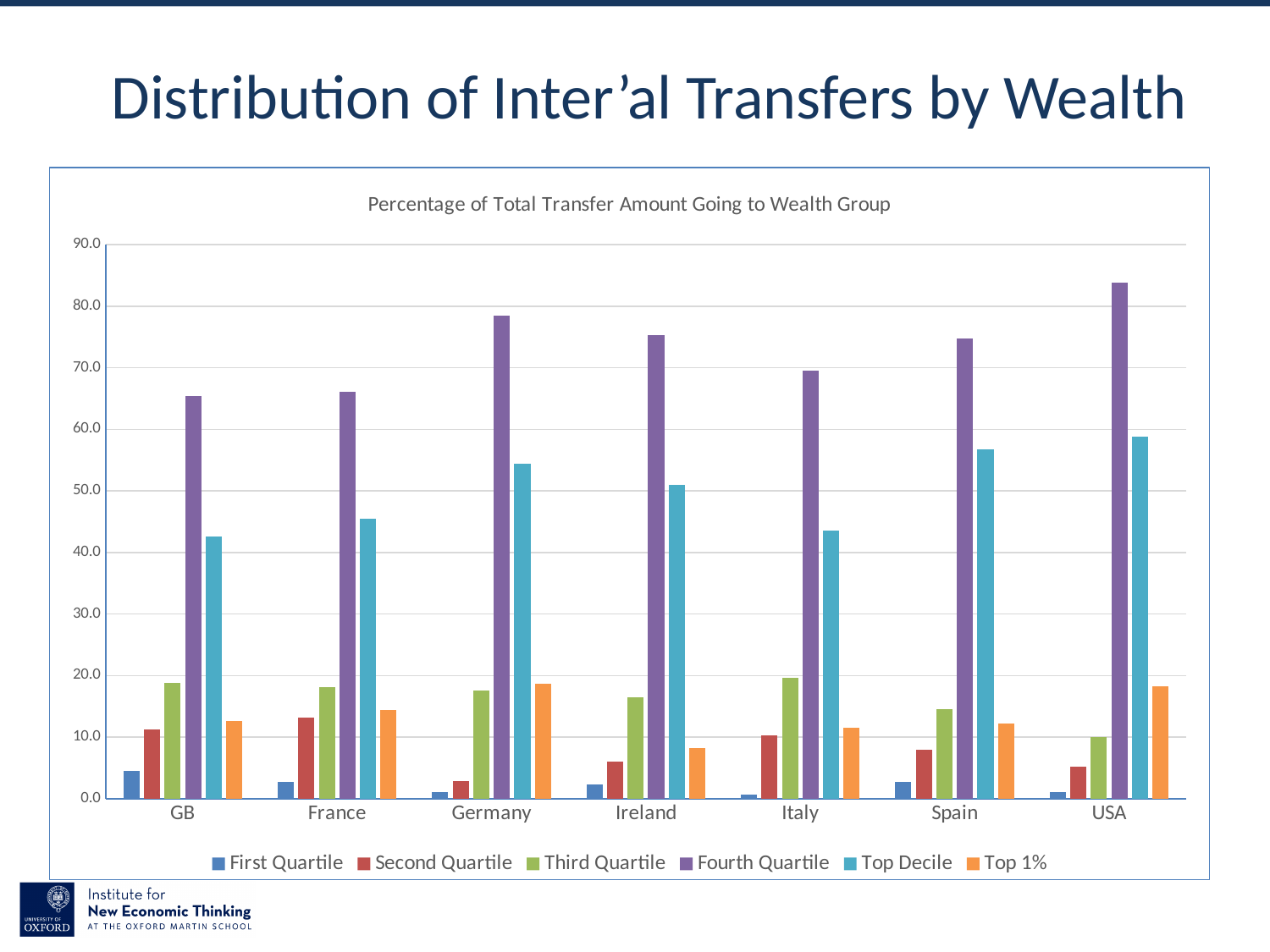
Which country has the highest Fourth Quartile value? USA Which country has the lowest Second Quartile value? Germany How many series does the chart's legend list? 6 Is the Fourth Quartile value for USA greater or less than 80.0? greater What is the title of the chart? Percentage of Total Transfer Amount Going to Wealth Group Is the Top Decile value for GB greater or less than 40.0? greater Which is larger, the Fourth Quartile value for Germany or for Ireland? Germany Is the Top 1% value for Ireland greater or less than 10.0? less Which country has the highest First Quartile value? GB How many countries are shown on the x axis of the chart? 7 Which country has the lowest Top 1% value? Ireland What kind of chart is shown on the slide? bar chart